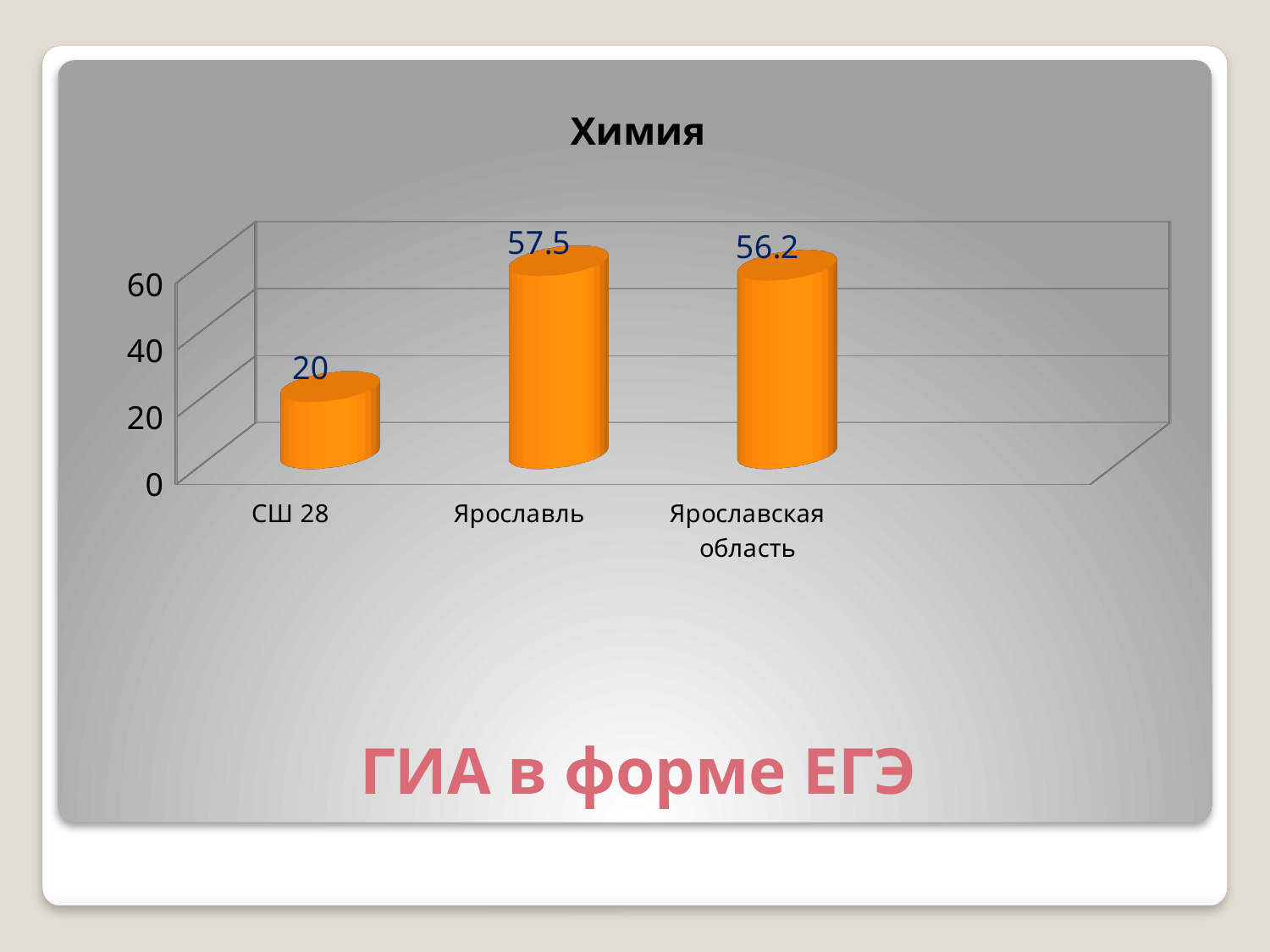
Is the value for Ярославская область greater or less than 40? greater Which category has the highest value? Ярославль What is the difference between the values for Ярославль and СШ 28? 37.5 What kind of chart is shown on the slide? bar chart What is the value for СШ 28? 20 What is the difference between the values for Ярославль and Ярославская область? 1.3 Which category has the lowest value? СШ 28 Which is larger, the value for СШ 28 or the value for Ярославская область? Ярославская область What is the title of the chart? Химия What is the value for Ярославская область? 56.2 What is the value for Ярославль? 57.5 How many categories are shown on the chart? 3